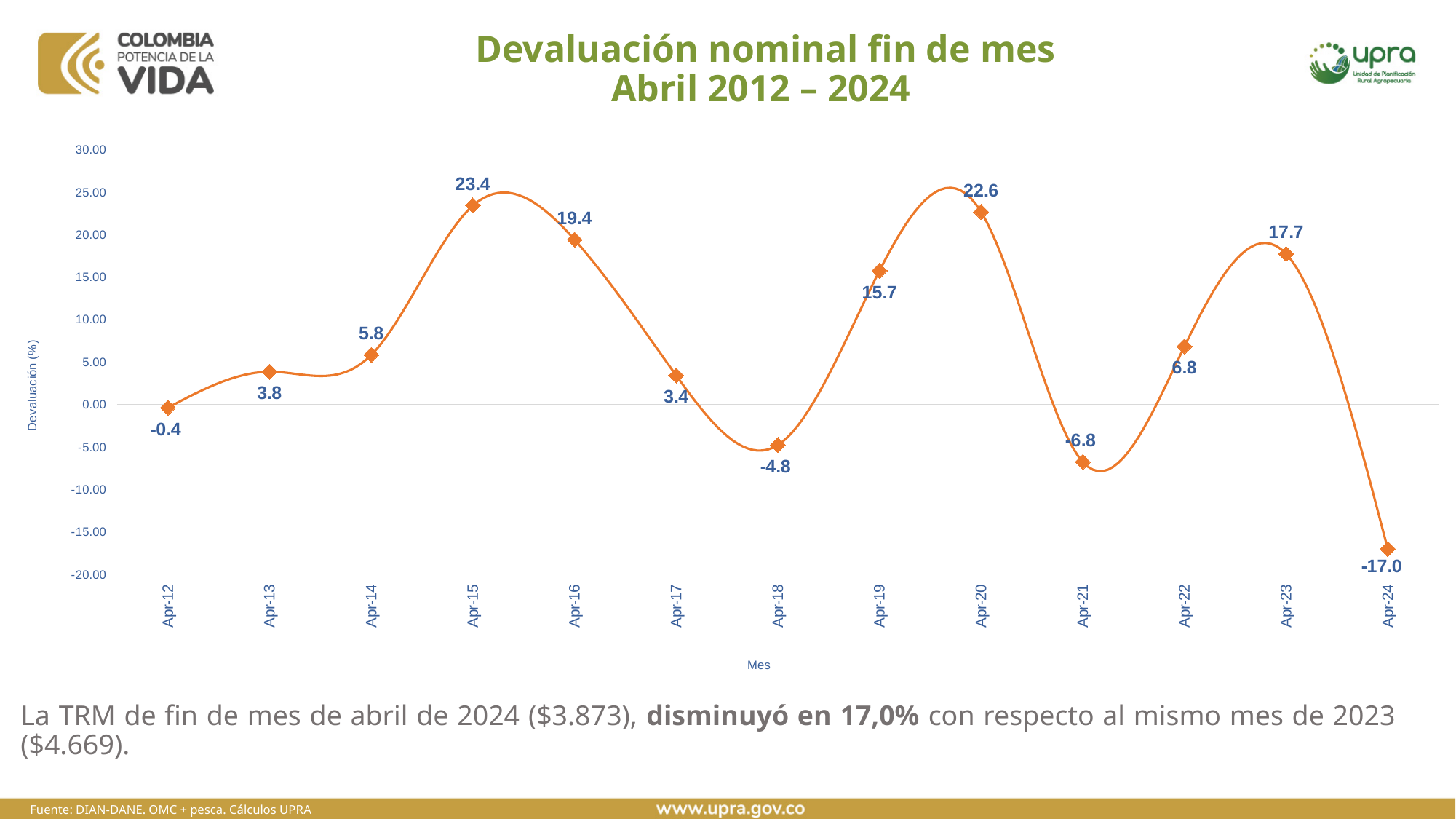
Which month has the lowest value? Apr-24 Which is larger, the value for Apr-16 or the value for Apr-23? Apr-16 How many data points are plotted on the chart? 13 What is the title of the chart? Devaluación nominal fin de mes Abril 2012 – 2024 Which month has the highest value? Apr-15 What is the difference between the values for Apr-20 and Apr-19? 6.9 What is the value for Apr-21? -6.8 What is the value for Apr-24? -17.0 What is the value for Apr-15? 23.4 What is the label of the vertical axis? Devaluación (%) What kind of chart is shown on the slide? Line chart Do the values rise or fall from Apr-23 to Apr-24? Fall